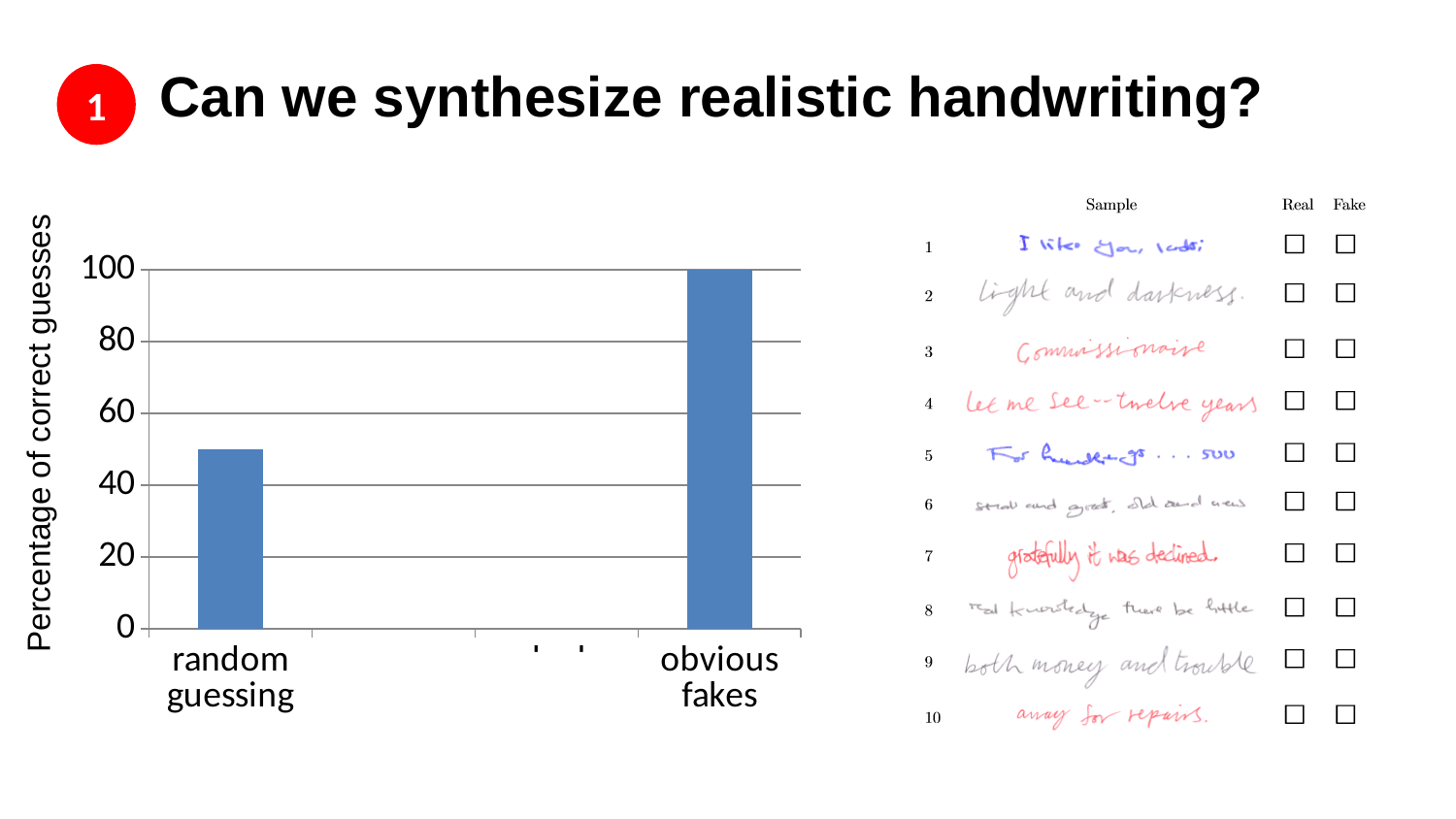
Is the value for "random guessing" greater or less than 40? greater Which is larger, the value for "random guessing" or the value for "obvious fakes"? obvious fakes What is the highest value shown on the vertical axis? 100 Which of the two labelled categories has the lower bar? random guessing Is the value for "obvious fakes" greater or less than 80? greater What type of chart is shown on the slide? bar chart Is the value for "random guessing" greater or less than 60? less What colour are the bars in the chart? blue Which labelled category has the highest bar? obvious fakes What is the percentage of correct guesses for "obvious fakes"? 100 What is the title of the vertical axis? Percentage of correct guesses